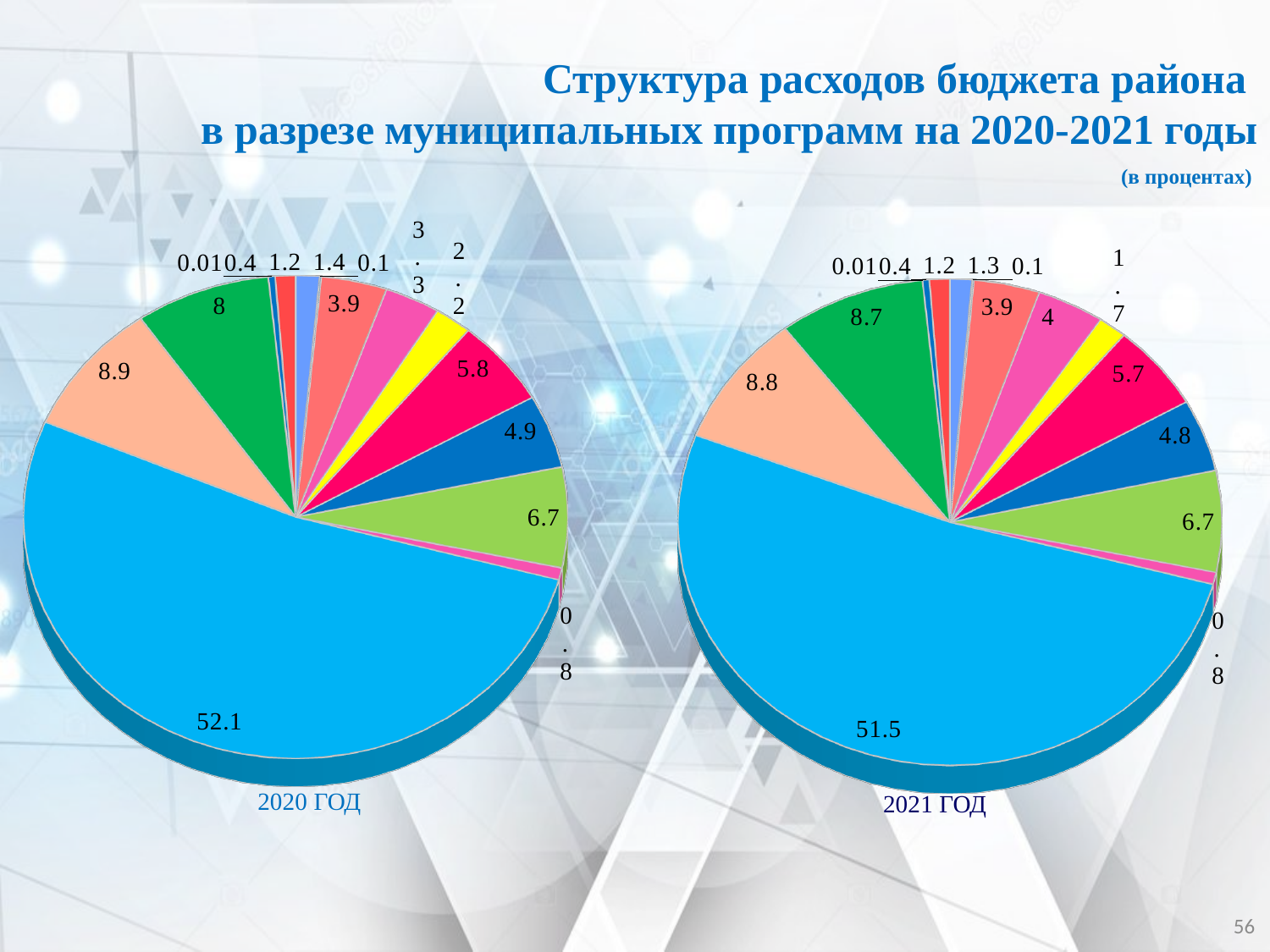
How many pie charts are shown on the slide? 2 In the 2020 ГОД pie chart, what is the value of the largest slice? 52.1 In the 2021 ГОД pie chart, what is the value of the dark green slice? 8.7 What is the difference between the largest slice of the 2020 ГОД chart and the largest slice of the 2021 ГОД chart? 0.6 In the 2021 ГОД pie chart, what is the value of the largest slice? 51.5 In the 2020 ГОД pie chart, what is the value of the light green slice? 6.7 In the 2021 ГОД pie chart, what is the value of the dark blue slice? 4.8 In the 2021 ГОД pie chart, what is the smallest labelled value? 0.01 What kind of chart is used for the 2020 ГОД data? pie chart In the 2020 ГОД pie chart, what is the value of the peach-coloured slice? 8.9 Which is larger: the peach-coloured slice in the 2020 ГОД chart or the peach-coloured slice in the 2021 ГОД chart? 2020 ГОД (8.9) How many slices does the 2020 ГОД pie chart have? 15